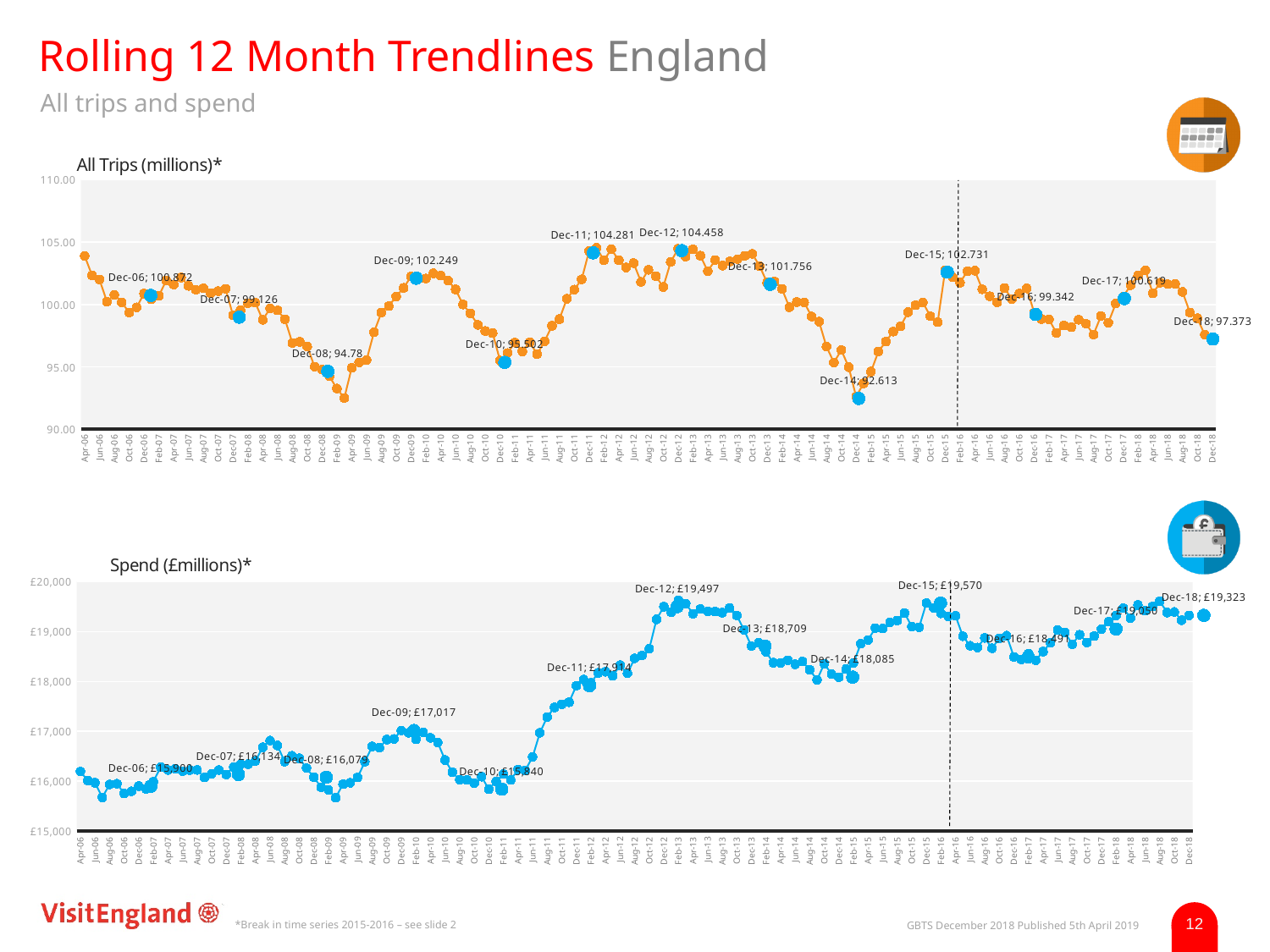
In the Spend (£millions) chart, what is the value labelled for Dec-15? £19,570 In the All Trips (millions) chart, what is the value labelled for Dec-09? 102.249 In the All Trips (millions) chart, what is the difference between the Dec-12 and Dec-11 values? 0.177 In the Spend (£millions) chart, what is the difference between the Dec-15 and Dec-14 values? £1,485 In the Spend (£millions) chart, what is the value labelled for Dec-12? £19,497 In the All Trips (millions) chart, what is the value labelled for Dec-08? 94.78 In the All Trips (millions) chart, what is the value labelled for Dec-14? 92.613 What type of chart is the All Trips (millions) chart? Line chart In the All Trips (millions) chart, which labelled December point has the highest value? Dec-12 In the All Trips (millions) chart, which labelled December point has the lowest value? Dec-14 In the Spend (£millions) chart, what is the value labelled for Dec-11? £17,914 In the Spend (£millions) chart, which is larger, the Dec-13 value or the Dec-14 value? Dec-13